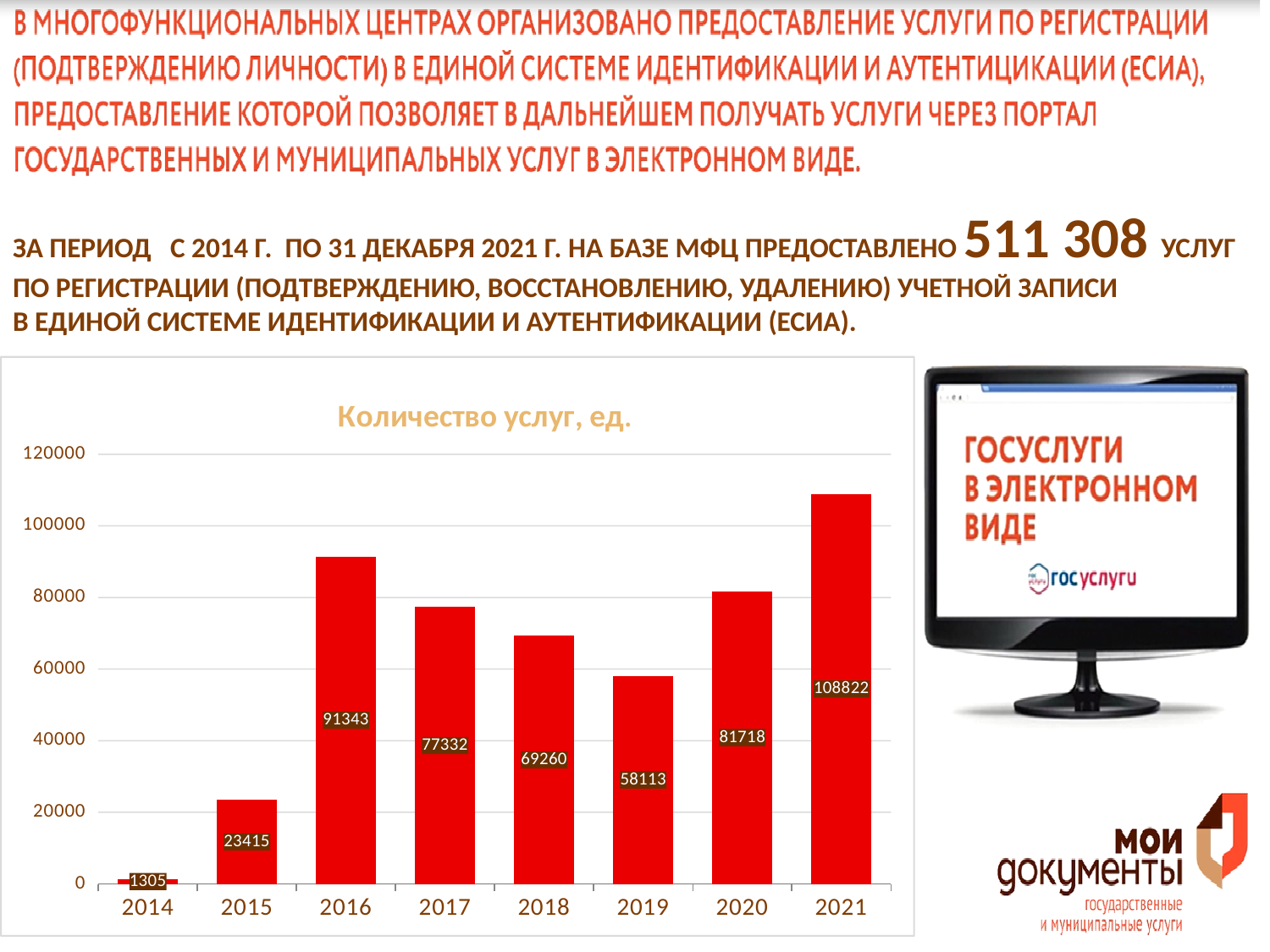
What is the value for 2014 in the chart "Количество услуг, ед."? 1305 Which year has the highest value in the chart "Количество услуг, ед."? 2021 Which year has the lowest value in the chart "Количество услуг, ед."? 2014 Which year has the larger value in the chart "Количество услуг, ед.", 2017 or 2020? 2020 What kind of chart is "Количество услуг, ед."? bar chart How many years are shown on the x axis of the chart "Количество услуг, ед."? 8 What is the value for 2016 in the chart "Количество услуг, ед."? 91343 What is the difference between the values for 2021 and 2016 in the chart "Количество услуг, ед."? 17479 What is the difference between the values for 2020 and 2019 in the chart "Количество услуг, ед."? 23605 Is the value for 2018 in the chart "Количество услуг, ед." greater or less than 60000? greater What is the value for 2019 in the chart "Количество услуг, ед."? 58113 In the chart "Количество услуг, ед.", do the values rise or fall from 2016 to 2019? fall